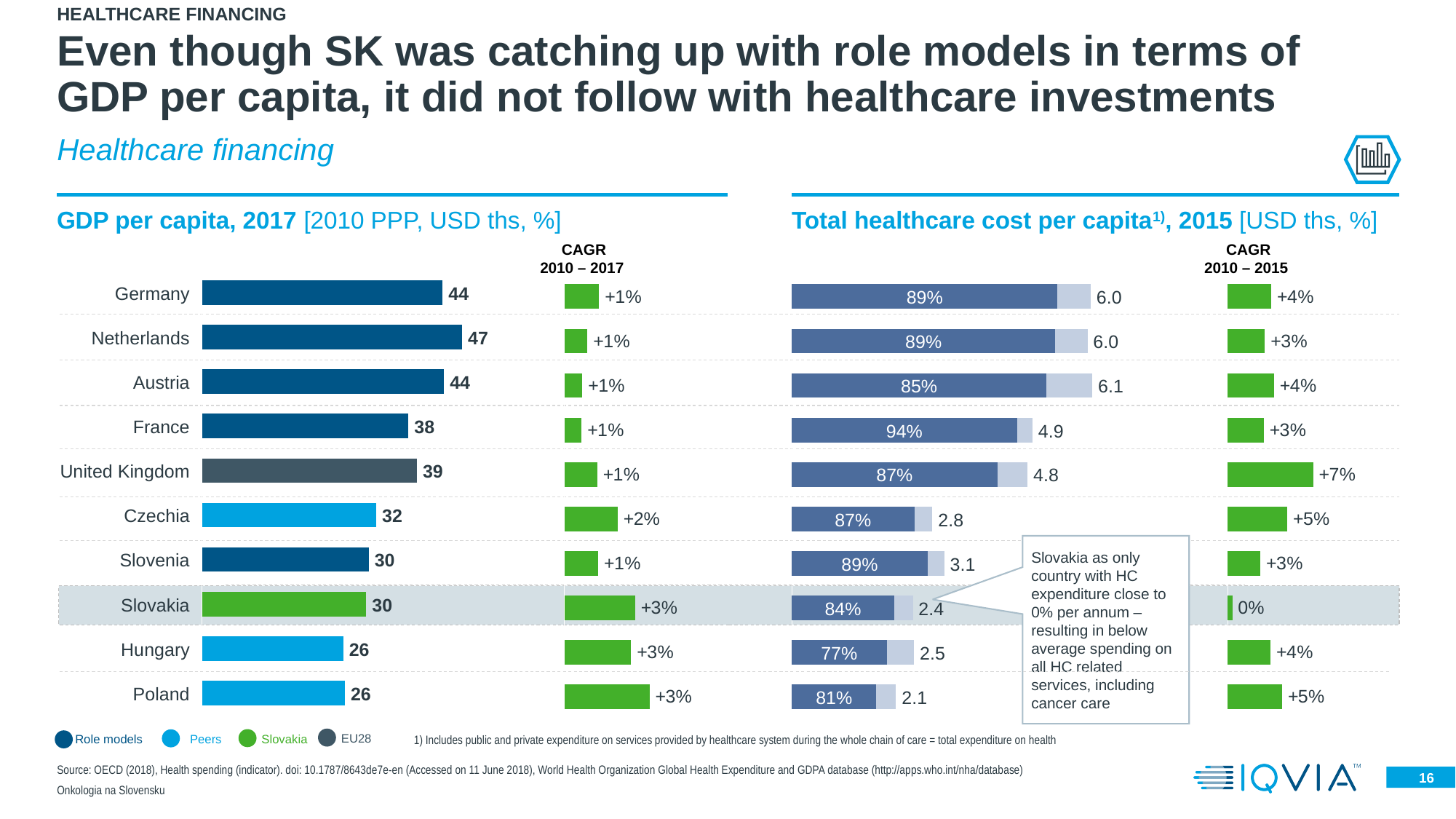
In the Total healthcare cost per capita, 2015 chart, what is the CAGR 2010 – 2015 for Slovakia? 0% In the Total healthcare cost per capita, 2015 chart, what is the CAGR 2010 – 2015 for the United Kingdom? +7% In the GDP per capita, 2017 chart, what is the difference between Germany and Slovakia? 14 In the Total healthcare cost per capita, 2015 chart, which is larger, the value for France or the United Kingdom? France In the GDP per capita, 2017 chart, which country has the highest value? Netherlands What kind of chart is the GDP per capita, 2017 chart? Bar chart In the Total healthcare cost per capita, 2015 chart, what is the value for Austria? 6.1 How many countries are listed in the GDP per capita, 2017 chart? 10 In the GDP per capita, 2017 chart, what is the CAGR 2010 – 2017 for Czechia? +2% In the GDP per capita, 2017 chart, what is the value for the Netherlands? 47 In the Total healthcare cost per capita, 2015 chart, which country has the lowest value? Poland In the Total healthcare cost per capita, 2015 chart, what percentage is shown for Hungary? 77%